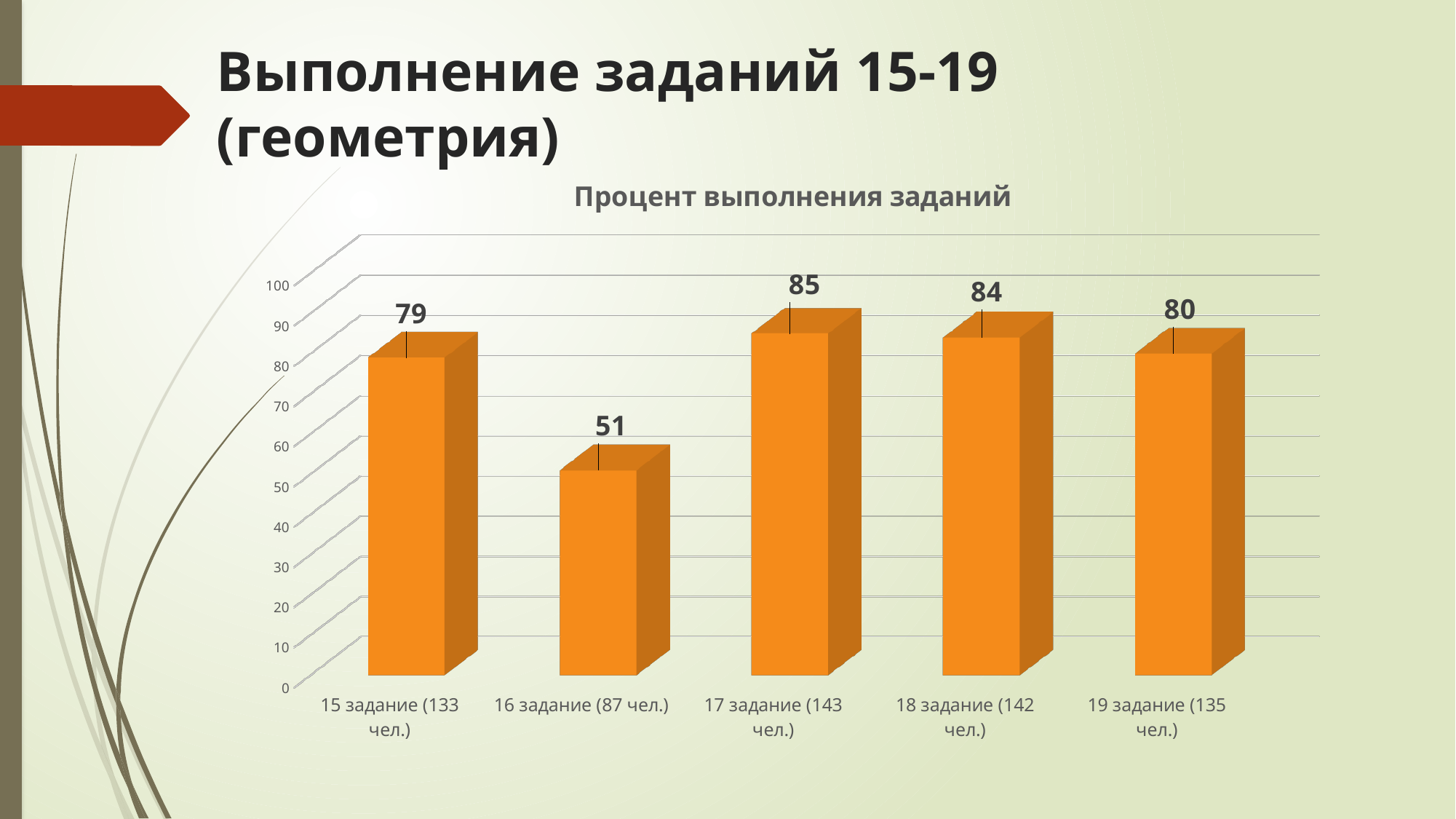
What kind of chart is shown on the slide? bar chart What is the value for 19 задание (135 чел.)? 80 Which category has the highest value? 17 задание (143 чел.) Is the value for 16 задание (87 чел.) greater or less than 60? less What is the value for 16 задание (87 чел.)? 51 What is the value for 17 задание (143 чел.)? 85 Which category has the lowest value? 16 задание (87 чел.) What is the difference between the values for 17 задание (143 чел.) and 16 задание (87 чел.)? 34 How many categories are shown on the chart? 5 What is the value for 15 задание (133 чел.)? 79 Which is larger, the value for 18 задание (142 чел.) or the value for 19 задание (135 чел.)? 18 задание (142 чел.) What is the title of the chart? Процент выполнения заданий